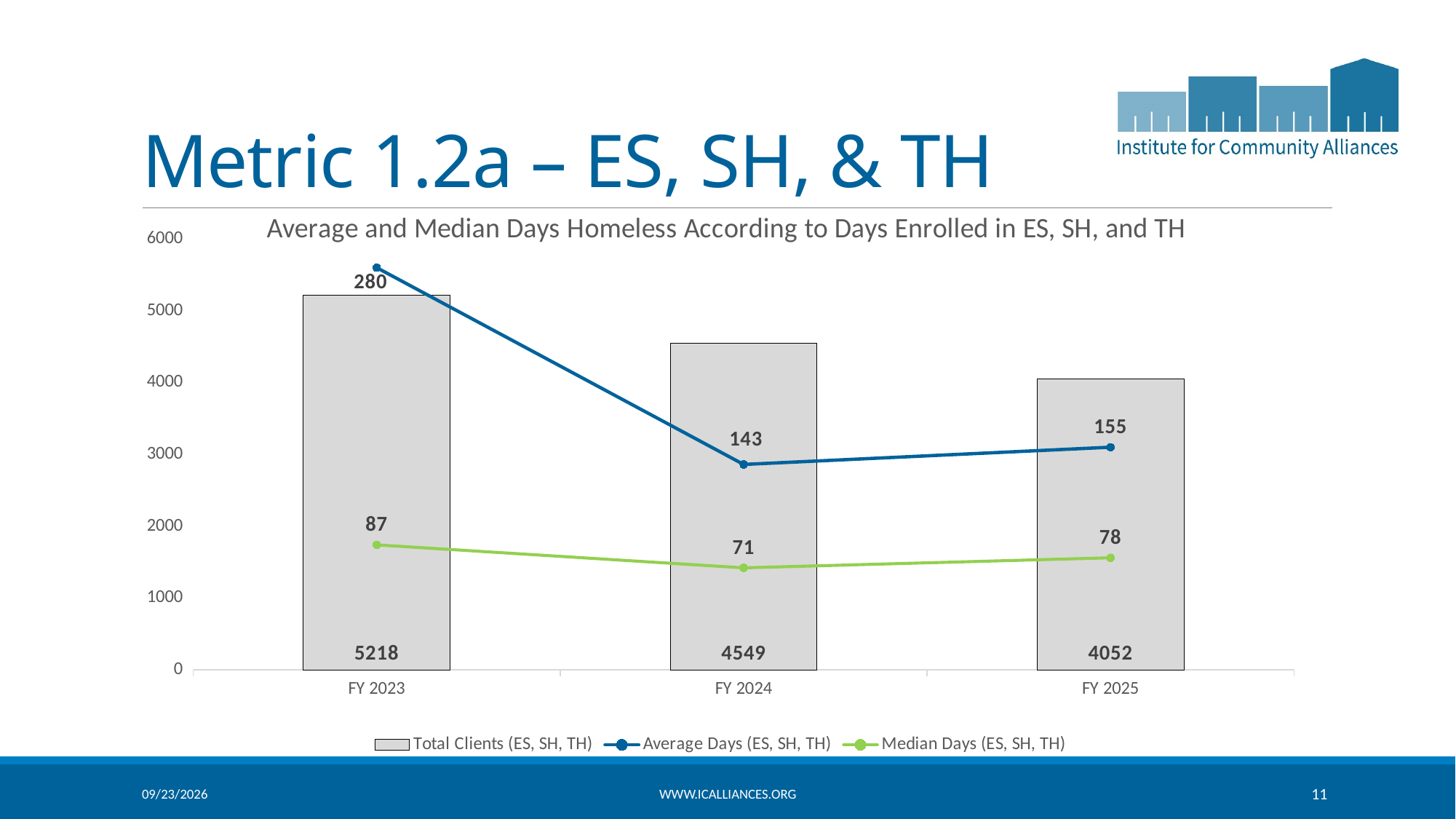
What is the value of Median Days (ES, SH, TH) for FY 2025? 78 What is the difference in Average Days (ES, SH, TH) between FY 2023 and FY 2024? 137 Is the Total Clients (ES, SH, TH) bar for FY 2024 greater or less than 4000? greater How many fiscal years are shown on the x axis? 3 What is the value of Total Clients (ES, SH, TH) for FY 2023? 5218 What is the difference in Total Clients (ES, SH, TH) between FY 2023 and FY 2025? 1166 What is the value of Average Days (ES, SH, TH) for FY 2024? 143 Which fiscal year has the lowest Median Days (ES, SH, TH)? FY 2024 Which is larger, Average Days (ES, SH, TH) in FY 2024 or in FY 2025? FY 2025 Does Total Clients (ES, SH, TH) rise or fall from FY 2023 to FY 2025? fall How many series does the legend list? 3 Which fiscal year has the highest Total Clients (ES, SH, TH)? FY 2023